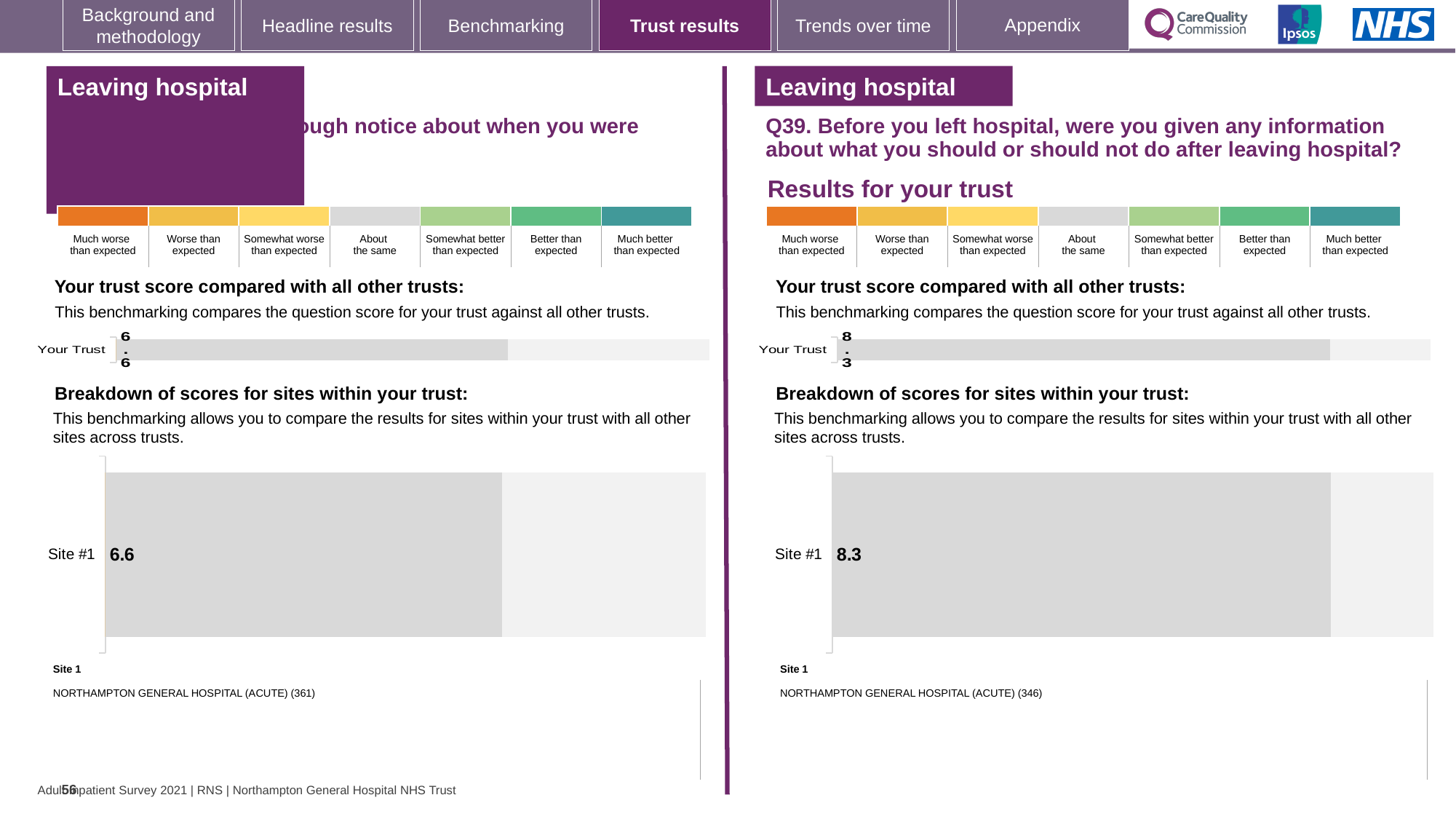
On the left-hand side of the slide, what is the score shown for Your Trust? 6.6 On the right-hand side of the slide (Q39), what is the score shown for Your Trust? 8.3 What is the difference between the Site #1 score on the right-hand side (Q39) and the Site #1 score on the left-hand side of the slide? 1.7 What type of chart is used to show the Site #1 score on the right-hand side of the slide (Q39)? Bar chart How many sites are shown in the 'Breakdown of scores for sites within your trust' chart on the left-hand side of the slide? 1 On the left-hand side of the slide, what is the score shown for Site #1? 6.6 How many sites are shown in the 'Breakdown of scores for sites within your trust' chart on the right-hand side of the slide (Q39)? 1 On the left-hand side of the slide, which site is listed as Site 1? NORTHAMPTON GENERAL HOSPITAL (ACUTE) (361) On the right-hand side of the slide (Q39), what is the score shown for Site #1? 8.3 Which is larger: the Site #1 score on the left-hand side of the slide or the Site #1 score on the right-hand side (Q39)? Right-hand side (Q39) On the right-hand side of the slide (Q39), which site is listed as Site 1? NORTHAMPTON GENERAL HOSPITAL (ACUTE) (346)